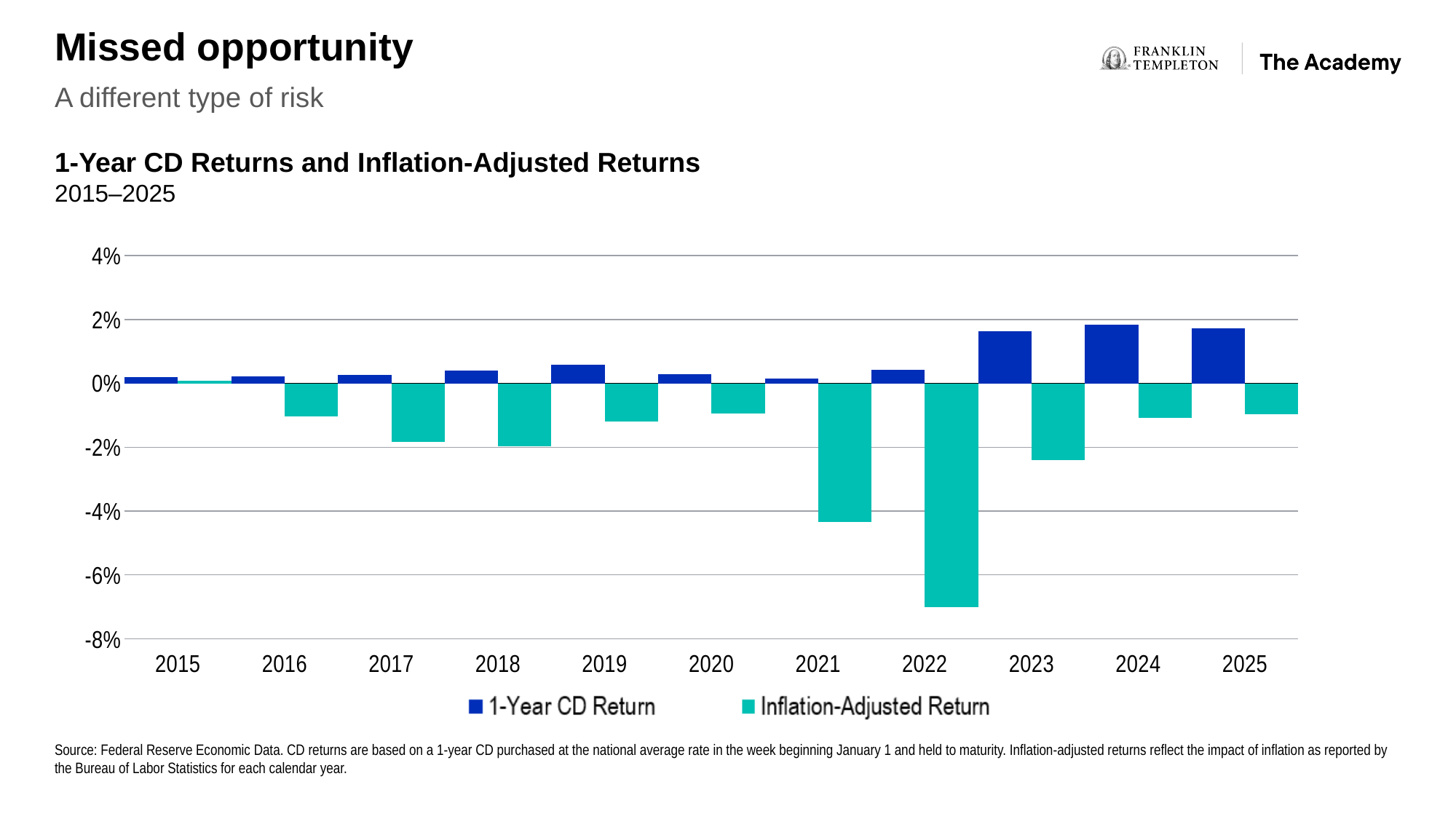
Is the Inflation-Adjusted Return for 2022 greater or less than -6%? less How many series does the legend list? 2 How many years are shown on the x axis? 11 Which year has the lowest Inflation-Adjusted Return? 2022 Which year has the lower Inflation-Adjusted Return, 2021 or 2022? 2022 Is the Inflation-Adjusted Return for 2021 greater or less than -4%? less Which year has the higher 1-Year CD Return, 2022 or 2023? 2023 What are the two series named in the legend? 1-Year CD Return and Inflation-Adjusted Return Is the Inflation-Adjusted Return for 2017 greater or less than -1%? less What kind of chart is shown on the slide? bar chart Which year has the highest Inflation-Adjusted Return? 2015